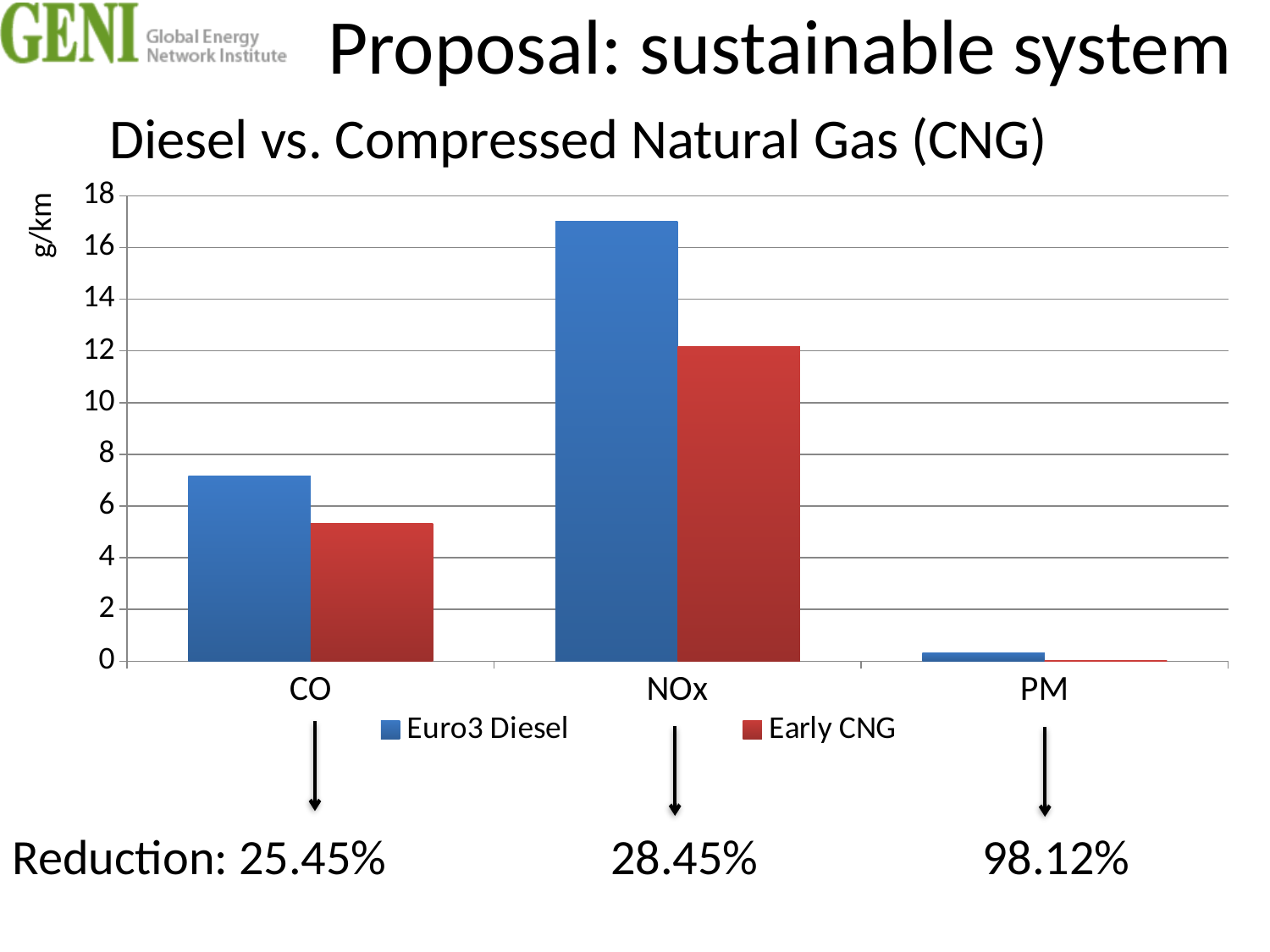
What kind of chart is shown on the slide? bar chart Is the Euro3 Diesel value for PM greater or less than 2? less For CO, which series has the larger value, Euro3 Diesel or Early CNG? Euro3 Diesel What reduction percentage is shown below the PM category? 98.12% Is the Euro3 Diesel value for NOx greater or less than 16? greater What unit is shown on the y axis of the chart? g/km How many series does the legend list? 2 Is the Early CNG value for NOx greater or less than 10? greater How many categories are shown on the x axis? 3 Which category has the lowest Early CNG value? PM Which category has the highest Euro3 Diesel value? NOx